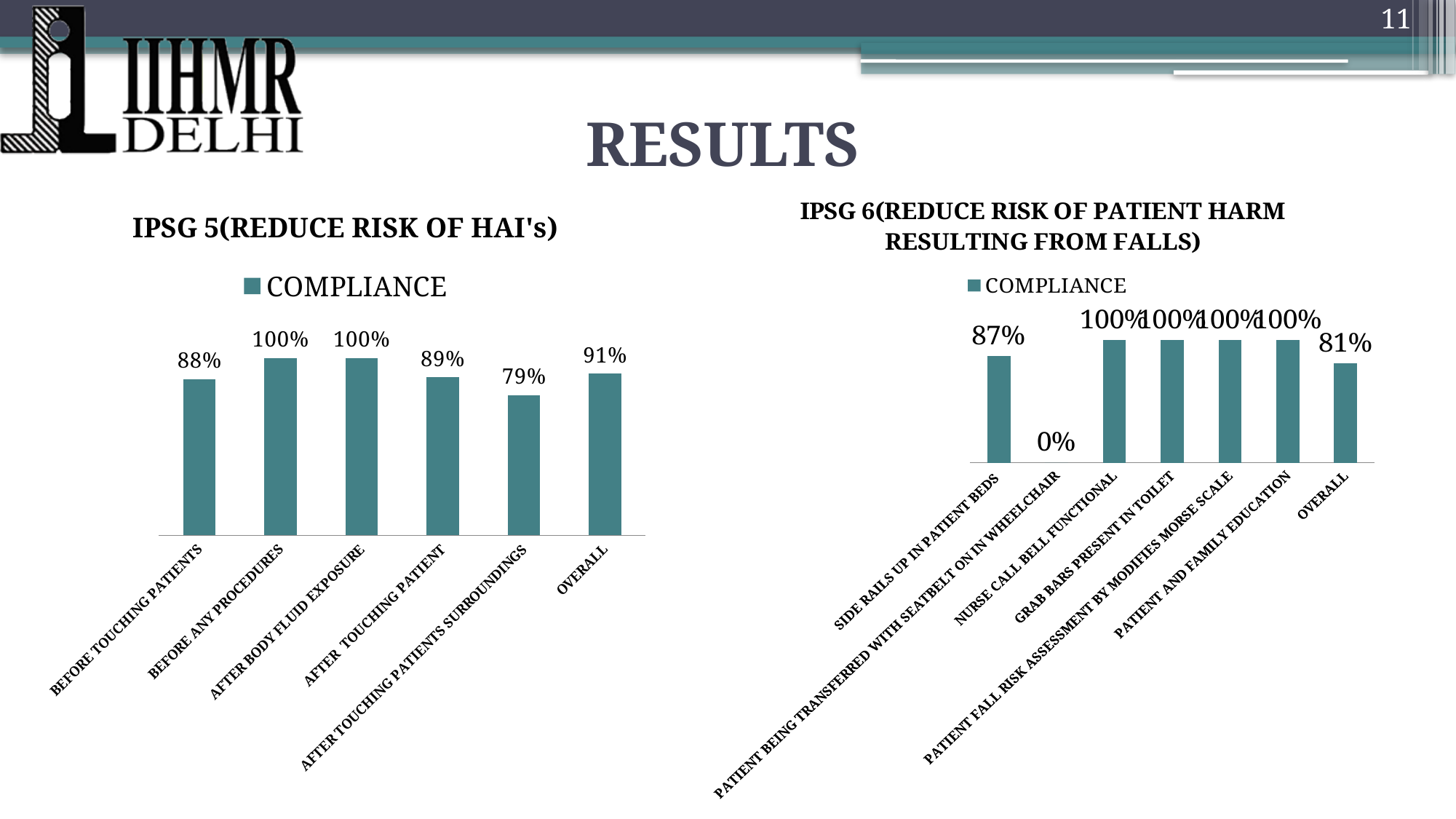
How many series does the legend of the IPSG 6 (REDUCE RISK OF PATIENT HARM RESULTING FROM FALLS) chart list? 1 In the IPSG 5 (REDUCE RISK OF HAI's) chart, how many categories are shown on the x axis? 6 In the IPSG 5 (REDUCE RISK OF HAI's) chart, what is the compliance value for BEFORE TOUCHING PATIENTS? 88% In the IPSG 5 (REDUCE RISK OF HAI's) chart, which category has the lowest compliance? AFTER TOUCHING PATIENTS SURROUNDINGS In the IPSG 6 (REDUCE RISK OF PATIENT HARM RESULTING FROM FALLS) chart, how many categories are shown on the x axis? 7 In the IPSG 6 (REDUCE RISK OF PATIENT HARM RESULTING FROM FALLS) chart, which category has the lowest compliance? PATIENT BEING TRANSFERRED WITH SEATBELT ON IN WHEELCHAIR In the IPSG 6 (REDUCE RISK OF PATIENT HARM RESULTING FROM FALLS) chart, which is larger: the value for SIDE RAILS UP IN PATIENT BEDS or the OVERALL value? SIDE RAILS UP IN PATIENT BEDS In the IPSG 6 (REDUCE RISK OF PATIENT HARM RESULTING FROM FALLS) chart, what is the compliance value for SIDE RAILS UP IN PATIENT BEDS? 87% In the IPSG 6 (REDUCE RISK OF PATIENT HARM RESULTING FROM FALLS) chart, what is the OVERALL compliance value? 81% What kind of chart is the IPSG 5 (REDUCE RISK OF HAI's) chart? Bar chart In the IPSG 5 (REDUCE RISK OF HAI's) chart, what is the compliance value for AFTER TOUCHING PATIENTS SURROUNDINGS? 79% In the IPSG 5 (REDUCE RISK OF HAI's) chart, what is the difference between the OVERALL value and the AFTER TOUCHING PATIENT value? 2%